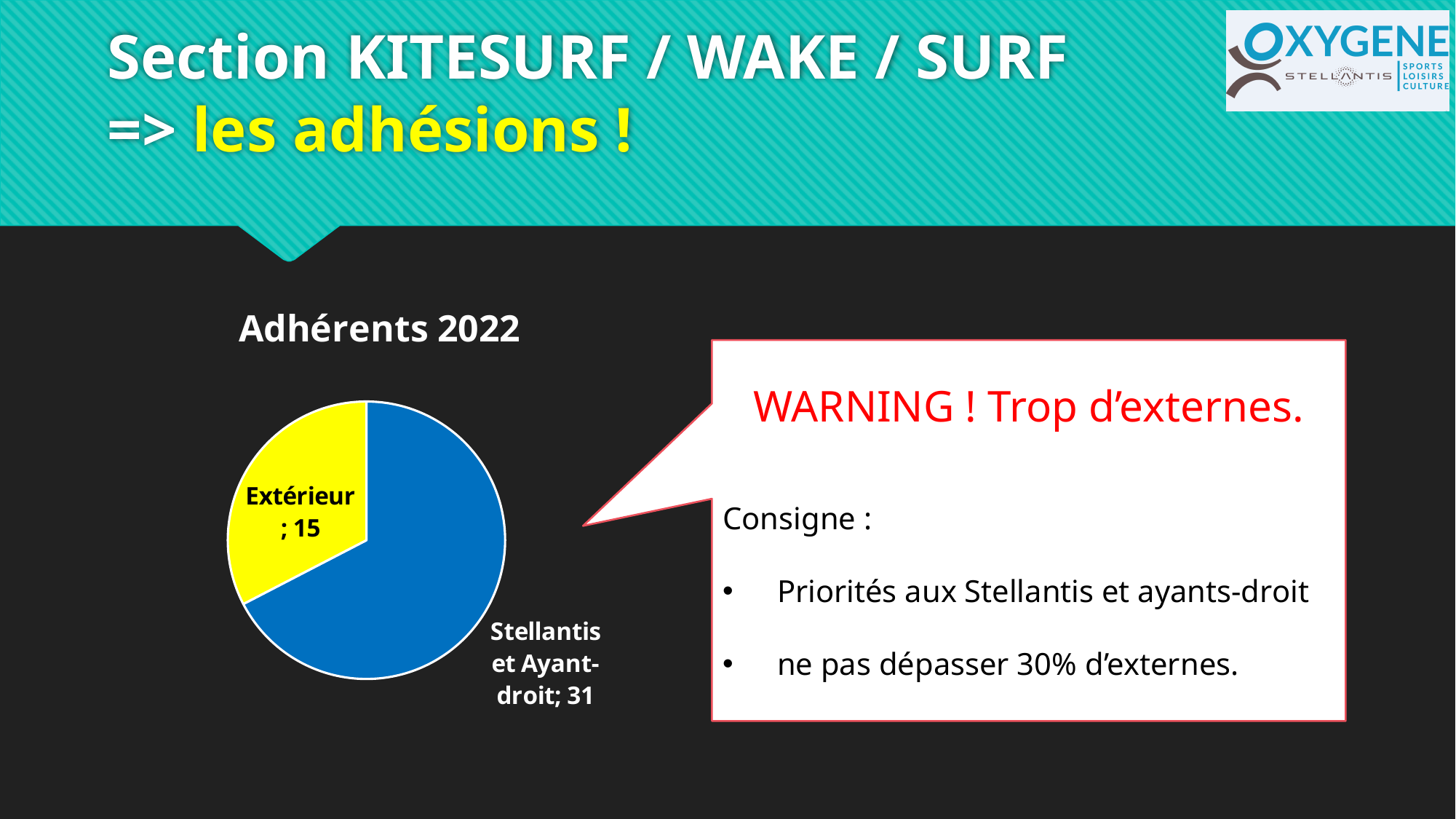
What is the value for Stellantis et Ayant-droit in the Adhérents 2022 pie chart? 31 What colour is the Extérieur slice in the Adhérents 2022 pie chart? yellow Which is larger in the Adhérents 2022 pie chart: Extérieur or Stellantis et Ayant-droit? Stellantis et Ayant-droit How many slices does the Adhérents 2022 pie chart have? 2 What share of the Adhérents 2022 pie chart does the Extérieur slice represent? 32.6% What is the total of all slices in the Adhérents 2022 pie chart? 46 What kind of chart is shown under the title 'Adhérents 2022'? pie chart What is the title of the pie chart on the slide? Adhérents 2022 What is the value for Extérieur in the Adhérents 2022 pie chart? 15 Which slice of the Adhérents 2022 pie chart is the largest? Stellantis et Ayant-droit What is the difference between the Stellantis et Ayant-droit value and the Extérieur value in the Adhérents 2022 pie chart? 16 Which slice of the Adhérents 2022 pie chart is the smallest? Extérieur